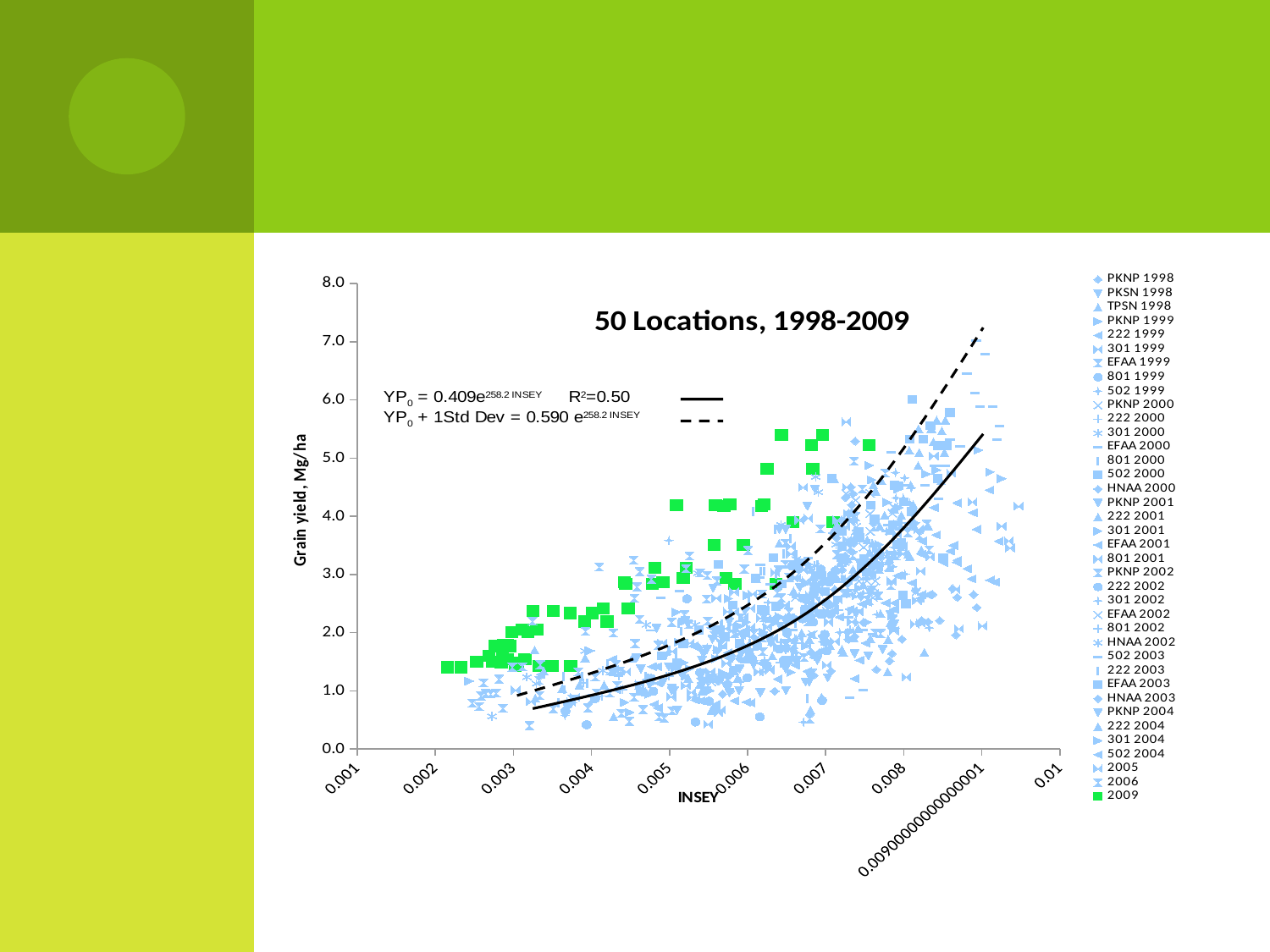
What is the highest tick value shown on the y axis? 8.0 What is the title of the chart? 50 Locations, 1998-2009 Does grain yield generally rise or fall as INSEY increases along the x axis? Rise What is the label of the y axis? Grain yield, Mg/ha What kind of chart is shown on the slide? Scatter chart What is the label of the x axis? INSEY What is the coefficient in the dashed-line equation YP0 + 1Std Dev = ___ e^(258.2 INSEY)? 0.590 What is the coefficient in the solid-line equation YP0 = ___ e^(258.2 INSEY)? 0.409 What R² value is printed on the chart for the fitted curve? 0.50 What is the lowest tick value shown on the x axis? 0.001 How many series does the legend list? 38